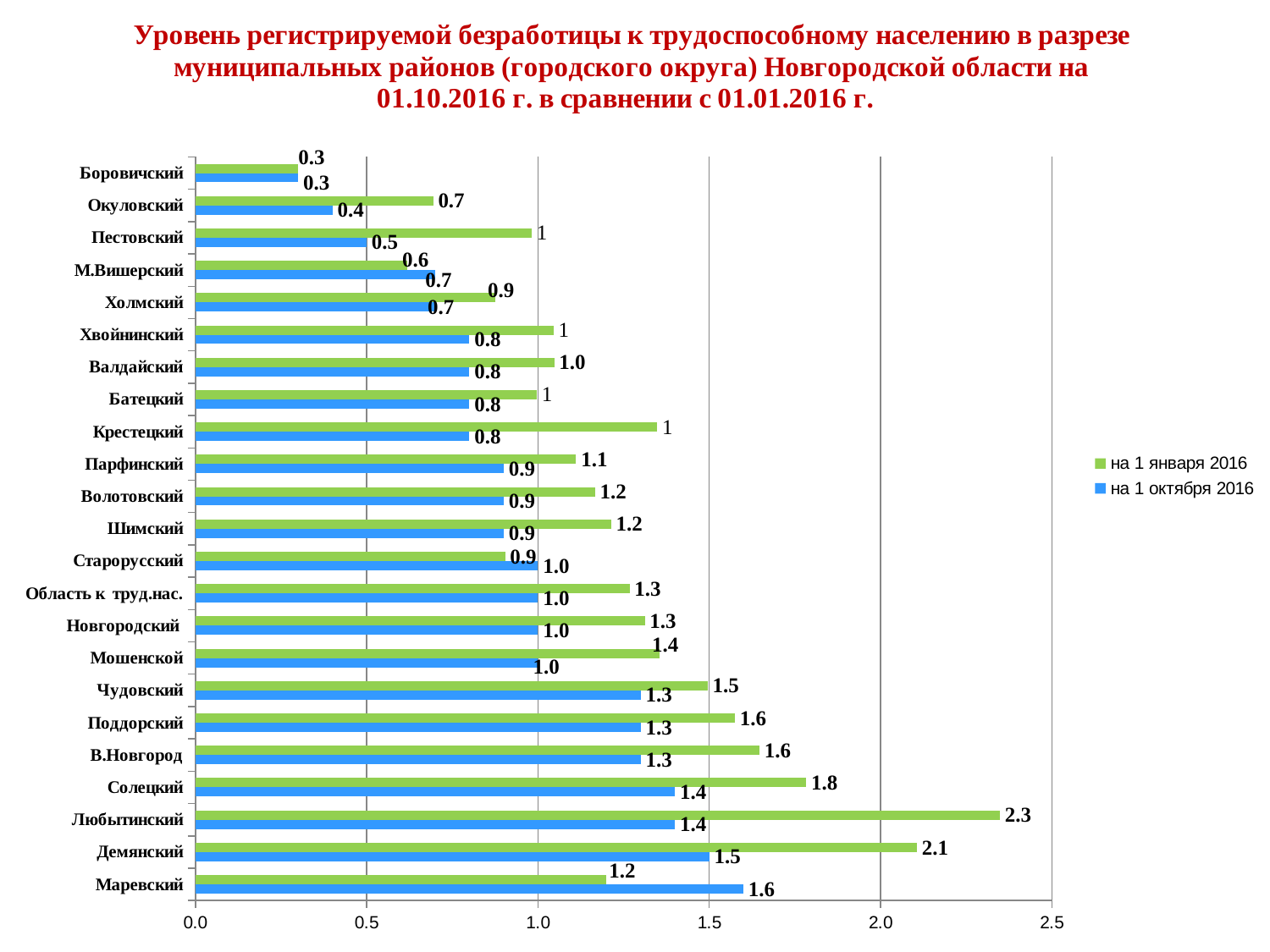
Which district has the highest value in the series 'на 1 октября 2016'? Маревский How many series does the legend list? 2 Which colour represents the series 'на 1 октября 2016'? blue What is the value for Солецкий in the series 'на 1 октября 2016'? 1.4 Which district has the lowest value in the series 'на 1 октября 2016'? Боровичский What is the value for Любытинский in the series 'на 1 января 2016'? 2.3 For Старорусский, which series has the larger value: 'на 1 января 2016' or 'на 1 октября 2016'? на 1 октября 2016 Which district has the highest value in the series 'на 1 января 2016'? Любытинский What is the value for Маревский in the series 'на 1 октября 2016'? 1.6 What is the difference between the 'на 1 января 2016' and 'на 1 октября 2016' values for Демянский? 0.6 What type of chart is shown on the slide? bar chart How many districts (categories) are plotted on the chart? 23